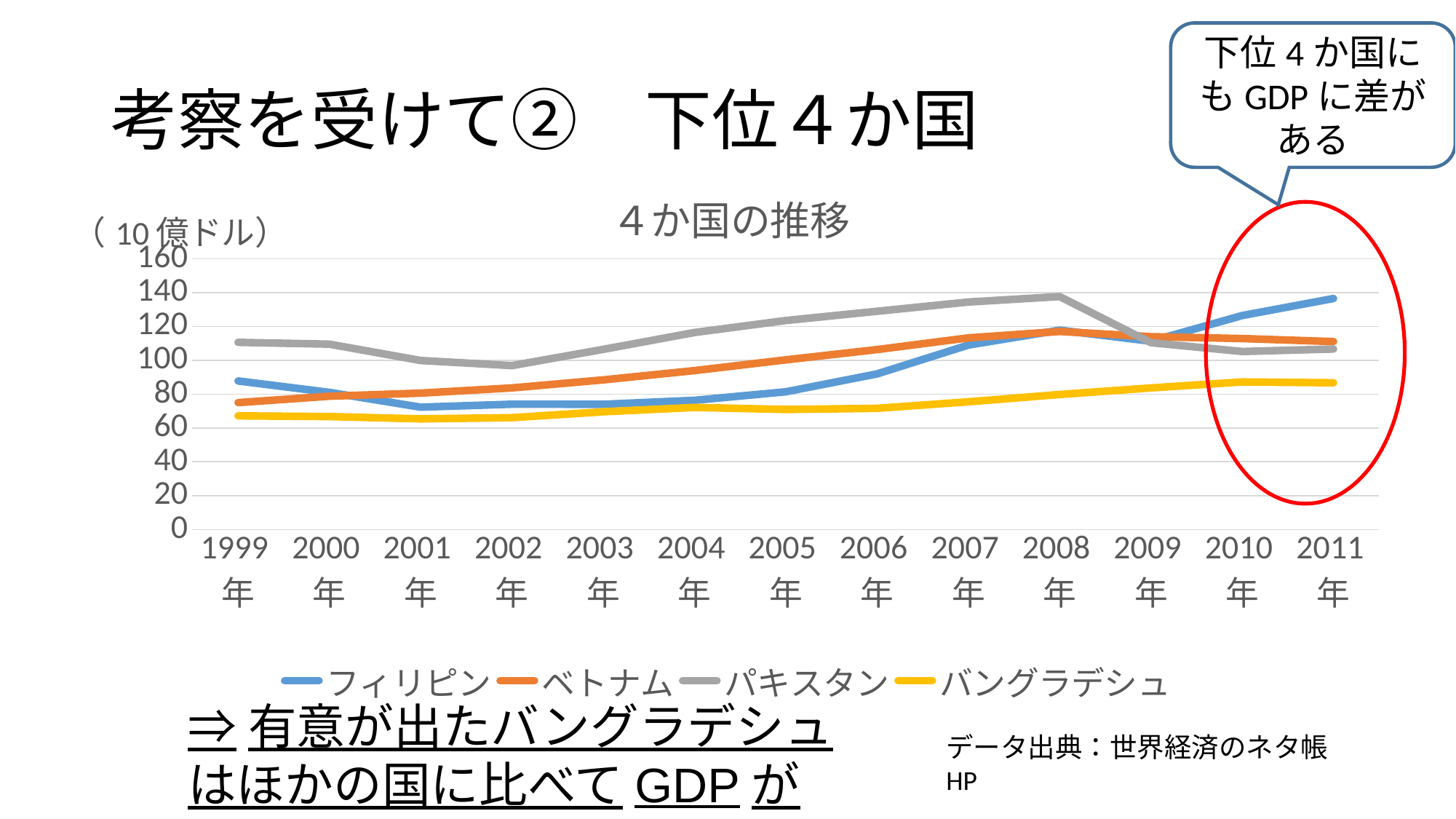
Which series has the lowest value in 2011? バングラデシュ What kind of chart is shown on the slide? line chart In 2011, which is larger: the value for フィリピン or the value for バングラデシュ? フィリピン Which series has the highest value in 2008? パキスタン How many series does the legend list? 4 Which series has the highest value in 2011? フィリピン Is the value for バングラデシュ in 2011 greater or less than 100? less How many years are plotted along the x axis? 13 Is the value for パキスタン in 2008 greater or less than 120? greater Is the value for フィリピン in 2011 greater or less than 120? greater What is the title of the chart? ４か国の推移 Does the value for バングラデシュ rise or fall from 1999 to 2011? rise